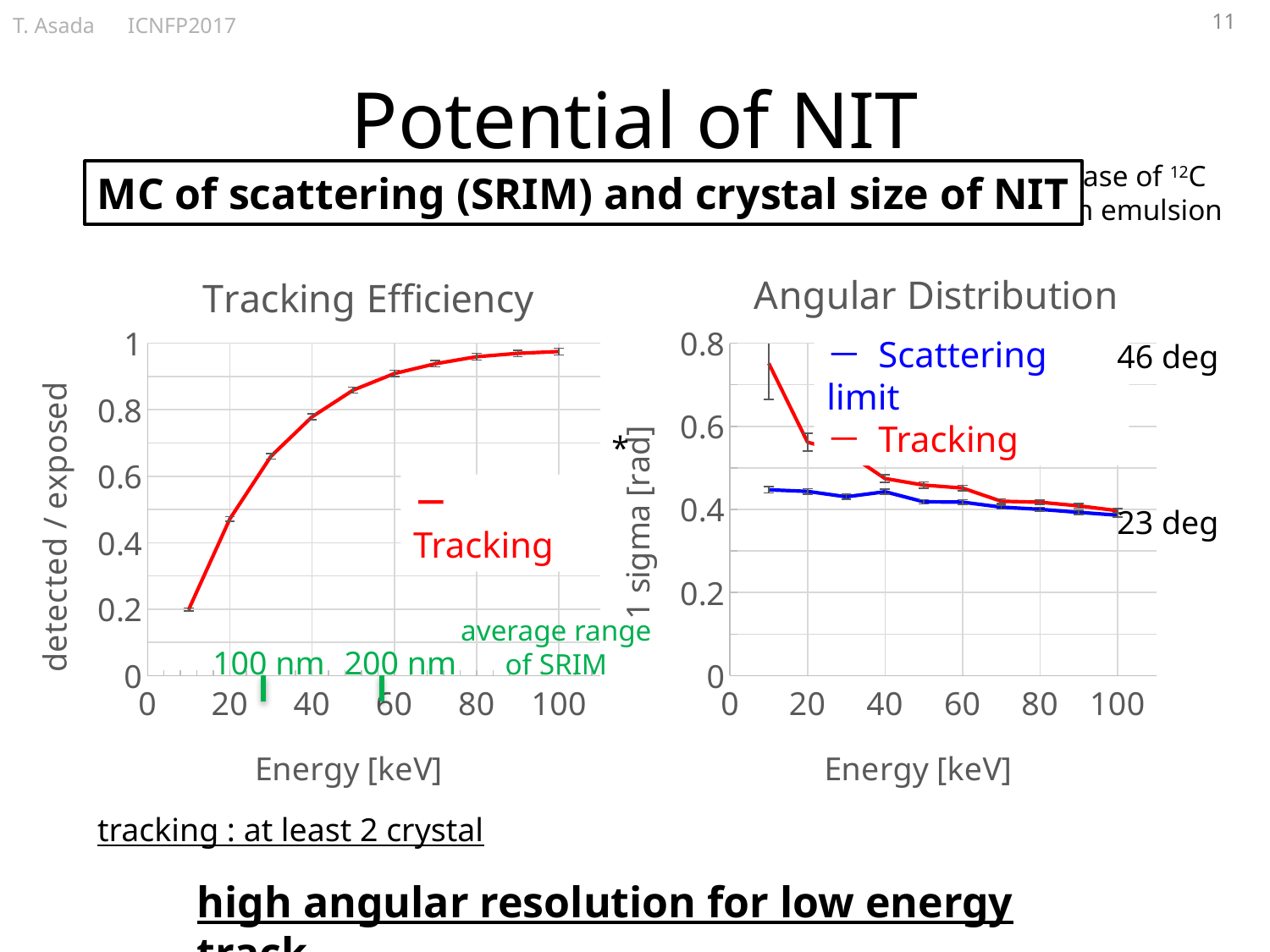
In the Angular Distribution chart, is the Tracking value at 10 keV greater or less than 0.6? greater In the Tracking Efficiency chart, how many data points are plotted on the Tracking line? 10 In the Tracking Efficiency chart, at which energy is the tracking efficiency lowest? 10 keV In the Tracking Efficiency chart, does the tracking efficiency rise or fall as energy increases? rise In the Angular Distribution chart, at which energy is the Tracking value highest? 10 keV In the Angular Distribution chart, at 10 keV, which is larger: Tracking or Scattering limit? Tracking In the Tracking Efficiency chart, is the value at 10 keV greater or less than 0.4? less In the Tracking Efficiency chart, is the value at 100 keV greater or less than 0.8? greater What is the y-axis label of the Tracking Efficiency chart? detected / exposed How many series does the legend of the Angular Distribution chart list? 2 In the Angular Distribution chart, does the Tracking series rise or fall as energy increases? fall What kind of chart is the Tracking Efficiency chart? line chart